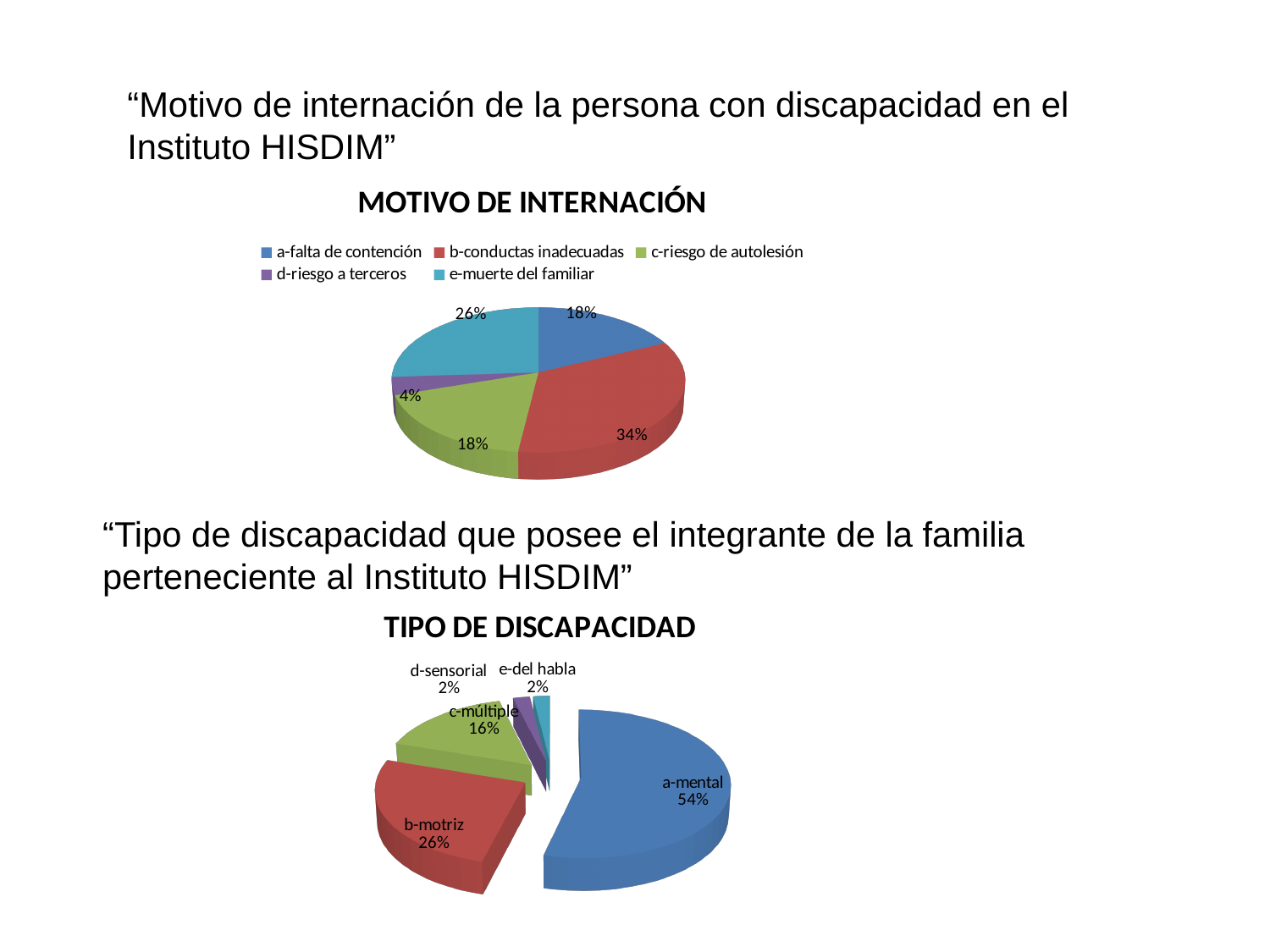
In the "TIPO DE DISCAPACIDAD" chart, what percentage is shown for c-múltiple? 16% In the "MOTIVO DE INTERNACIÓN" chart, what percentage is shown for e-muerte del familiar? 26% In the "MOTIVO DE INTERNACIÓN" chart, how many categories does the legend list? 5 In the "TIPO DE DISCAPACIDAD" chart, which is larger, b-motriz or c-múltiple? b-motriz In the "TIPO DE DISCAPACIDAD" chart, what percentage is shown for a-mental? 54% In the "TIPO DE DISCAPACIDAD" chart, what is the difference in percentage points between a-mental and b-motriz? 28 In the "MOTIVO DE INTERNACIÓN" chart, which category has the largest share? b-conductas inadecuadas What kind of chart is the "TIPO DE DISCAPACIDAD" chart? Pie chart In the "MOTIVO DE INTERNACIÓN" chart, what percentage is shown for b-conductas inadecuadas? 34% In the "MOTIVO DE INTERNACIÓN" chart, which category has the smallest share? d-riesgo a terceros In the "MOTIVO DE INTERNACIÓN" chart, which colour represents d-riesgo a terceros? Purple In the "MOTIVO DE INTERNACIÓN" chart, what is the difference in percentage points between b-conductas inadecuadas and e-muerte del familiar? 8